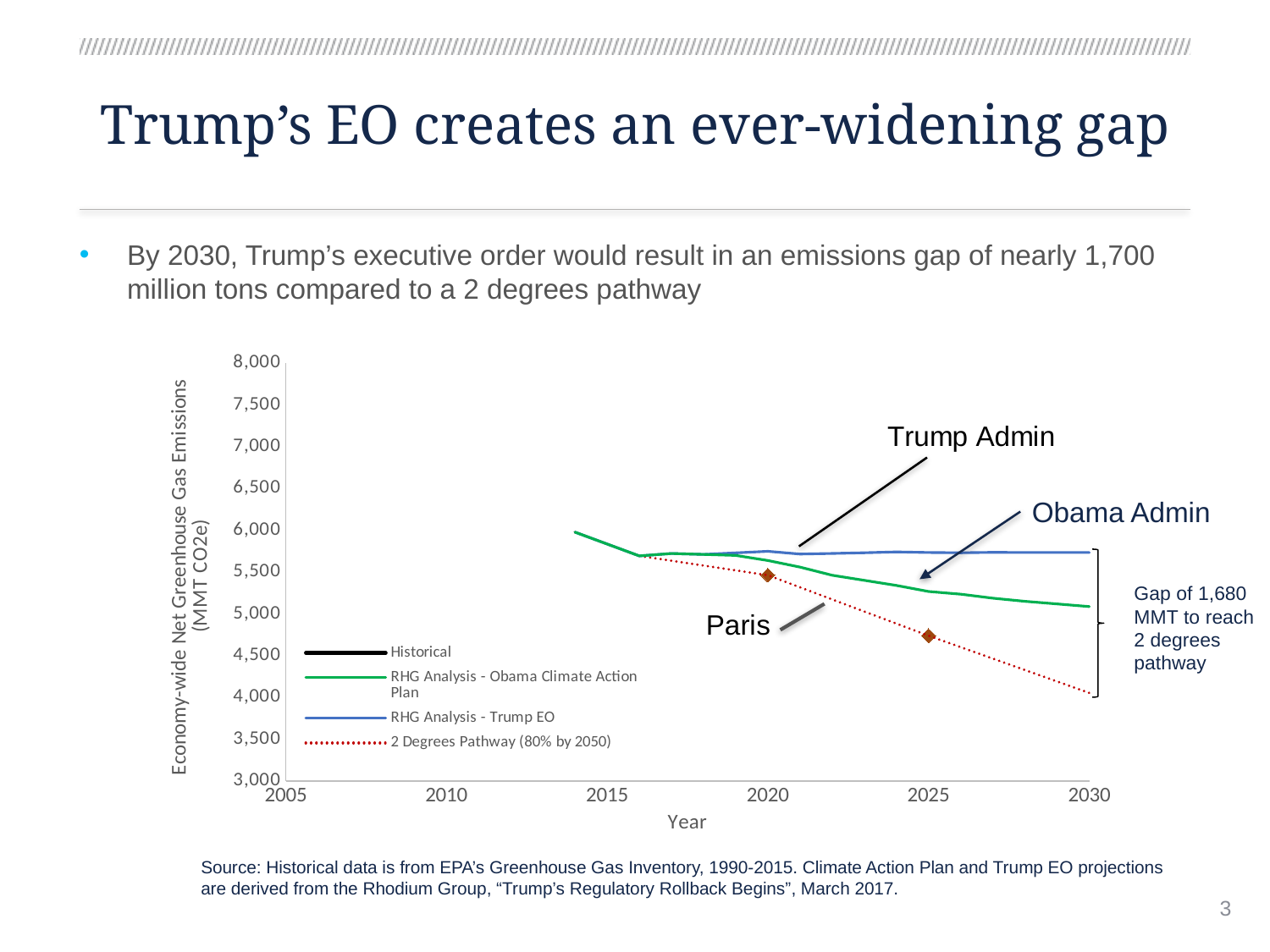
Is the value of the RHG Analysis - Trump EO series in 2030 greater or less than 5,500? greater According to the annotation on the chart, what is the size of the gap to reach the 2 degrees pathway in 2030? 1,680 MMT Is the value of the 2 Degrees Pathway series in 2025 greater or less than 5,000? less What kind of chart is shown on the slide? line chart What is the title of the vertical axis of the chart? Economy-wide Net Greenhouse Gas Emissions (MMT CO2e) Is the value of the 2 Degrees Pathway series in 2030 greater or less than 4,500? less Does the 2 Degrees Pathway series rise or fall between 2020 and 2030? fall In 2025, which series has the higher value: RHG Analysis - Obama Climate Action Plan or 2 Degrees Pathway? RHG Analysis - Obama Climate Action Plan Which legend entry is drawn as a red dotted line? 2 Degrees Pathway (80% by 2050) In 2030, which series has the higher value: RHG Analysis - Trump EO or RHG Analysis - Obama Climate Action Plan? RHG Analysis - Trump EO How many series does the chart legend list? 4